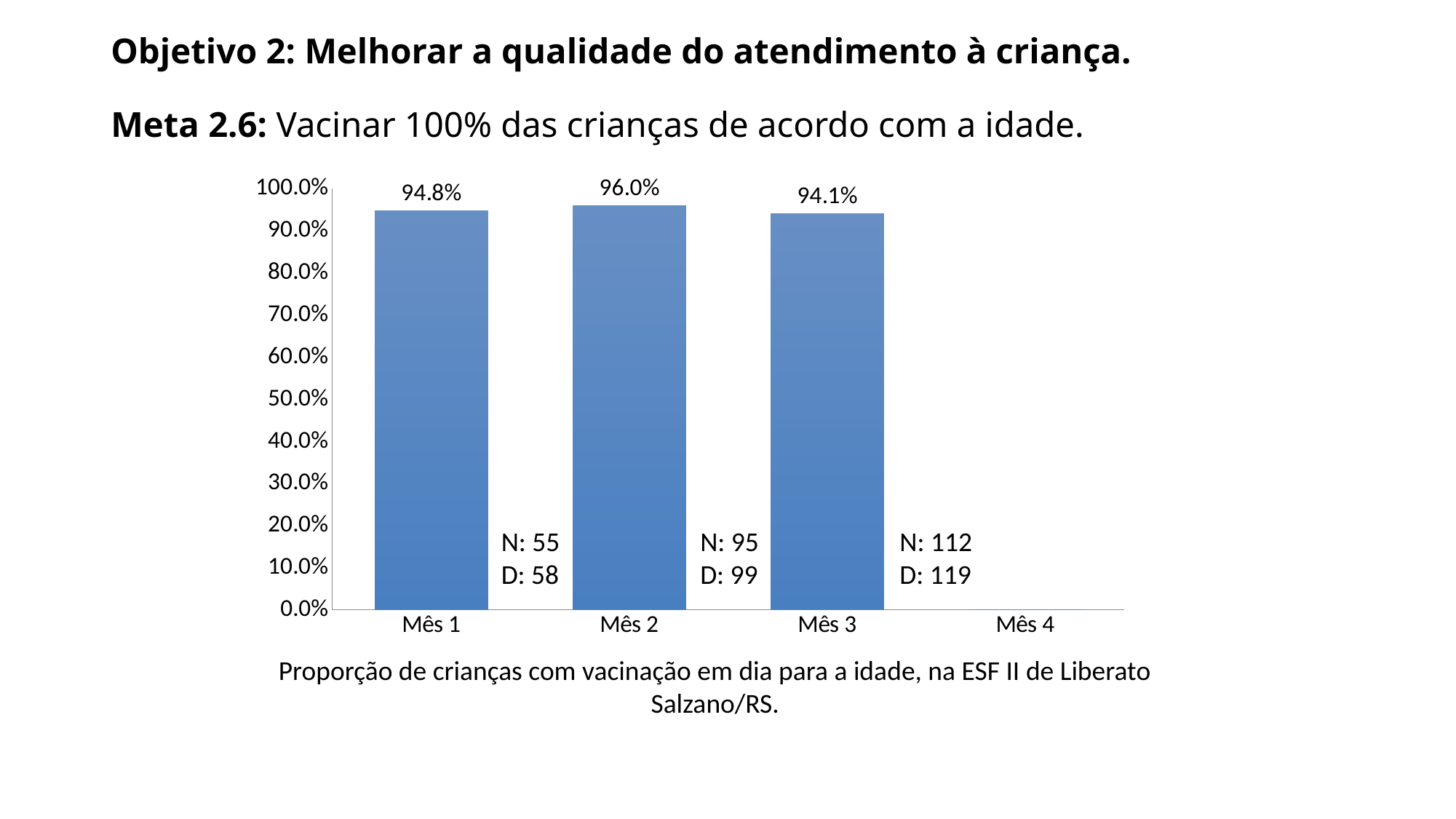
Which is larger, the value for Mês 1 or the value for Mês 2? Mês 2 What is the denominator (D) shown for Mês 3? 119 What is the value for Mês 1? 94.8% What kind of chart is shown on the slide? bar chart What is the difference between the values for Mês 2 and Mês 1? 1.2% Is the value for Mês 3 greater or less than 90.0%? greater Among the months with a plotted bar, which has the lowest value? Mês 3 How many month categories are shown on the x axis? 4 What is the difference between the values for Mês 2 and Mês 3? 1.9% What is the value for Mês 3? 94.1% What is the value for Mês 2? 96.0% Which month has the highest value? Mês 2